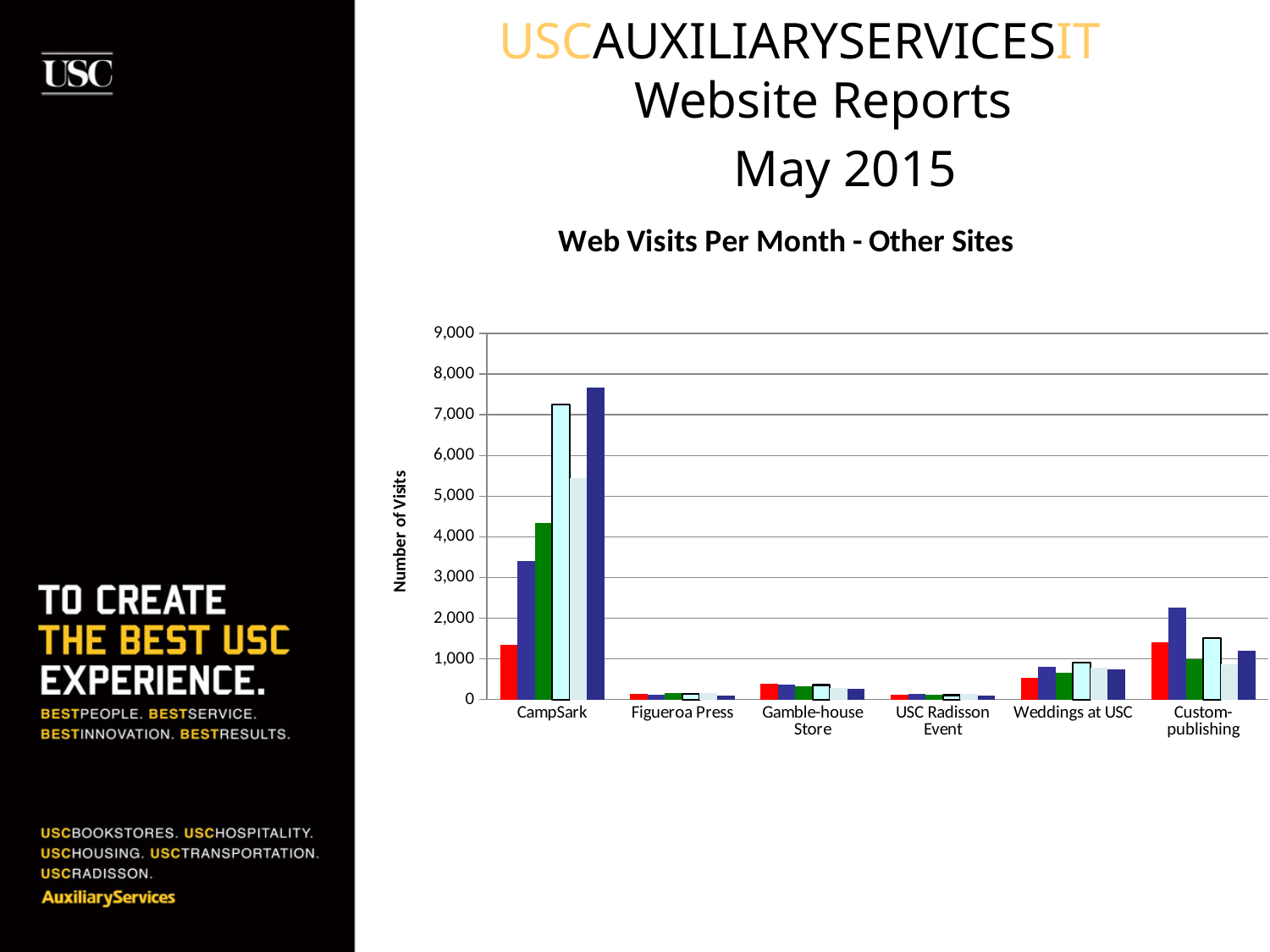
Are all the bars for Gamble-house Store greater or less than 1,000? less What is the label on the vertical axis of the chart? Number of Visits Which site has the highest number of visits in the chart? CampSark What type of chart is shown on the slide? bar chart What is the title of the chart? Web Visits Per Month - Other Sites How many site categories are shown along the x axis? 6 How many bars are plotted for each site category? 6 Which site has higher visit bars, Weddings at USC or Figueroa Press? Weddings at USC Is the tallest bar for CampSark greater or less than 7,000? greater Is the tallest bar for Custom-publishing greater or less than 2,000? greater Which site has the larger tallest bar, CampSark or Custom-publishing? CampSark